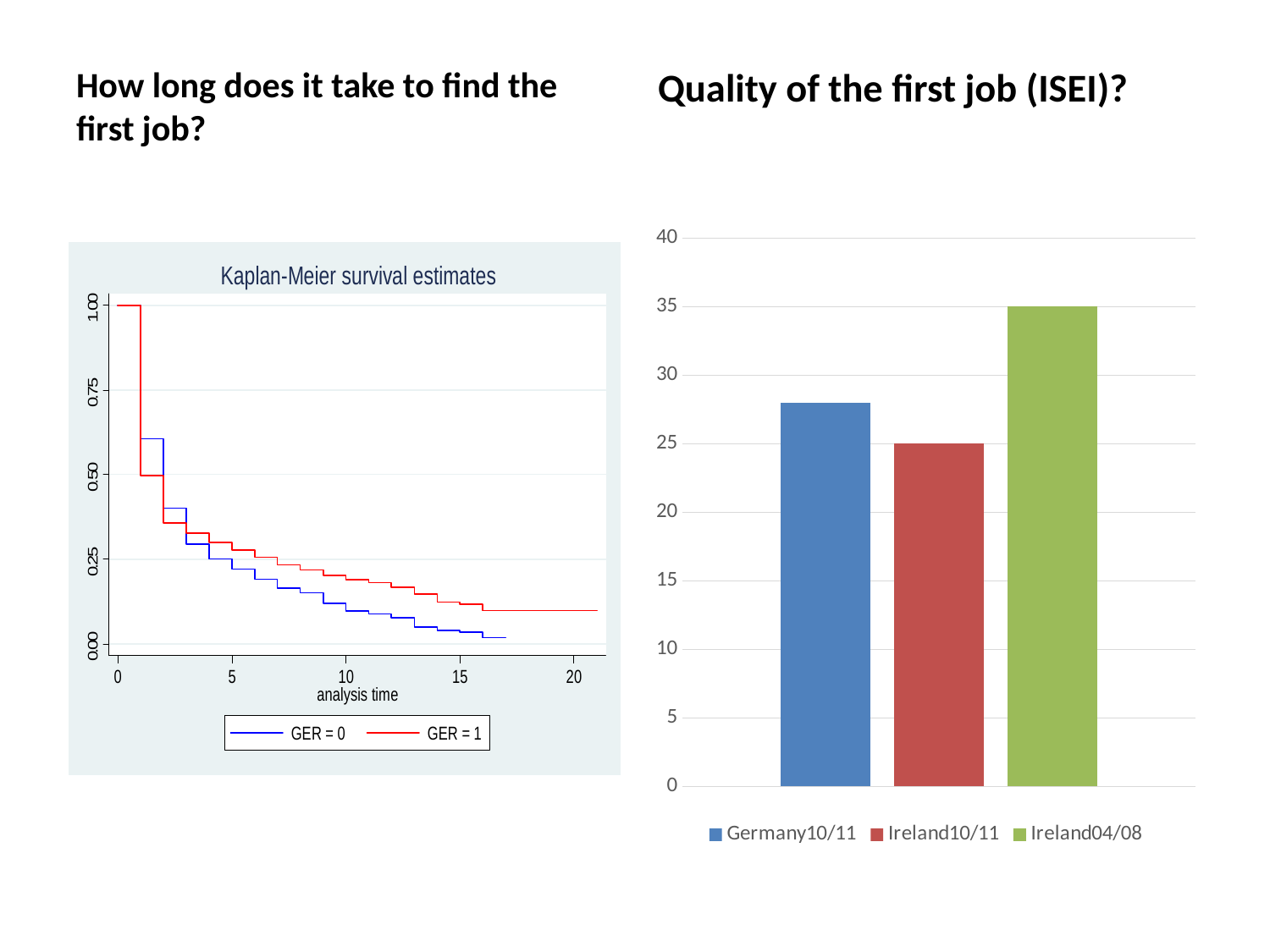
On the 'Quality of the first job (ISEI)?' chart, which category has the lowest value? Ireland10/11 On the 'Quality of the first job (ISEI)?' chart, what is the difference between Ireland04/08 and Ireland10/11? 10 On the 'Quality of the first job (ISEI)?' chart, what is the value for Ireland04/08? 35 On the 'Quality of the first job (ISEI)?' chart, what is the value for Ireland10/11? 25 On the 'Quality of the first job (ISEI)?' chart, which category has the highest value? Ireland04/08 How many series does the legend of the 'Kaplan-Meier survival estimates' chart list? 2 On the 'Quality of the first job (ISEI)?' chart, which is larger, Germany10/11 or Ireland10/11? Germany10/11 On the 'Quality of the first job (ISEI)?' chart, is the value for Germany10/11 greater or less than 25? greater On the 'Kaplan-Meier survival estimates' chart, do the survival estimates rise or fall as analysis time increases? fall How many bars are shown on the 'Quality of the first job (ISEI)?' chart? 3 On the 'Kaplan-Meier survival estimates' chart, at analysis time 10, is the value for GER = 0 greater or less than 0.25? less What kind of chart is the 'Quality of the first job (ISEI)?' chart? bar chart